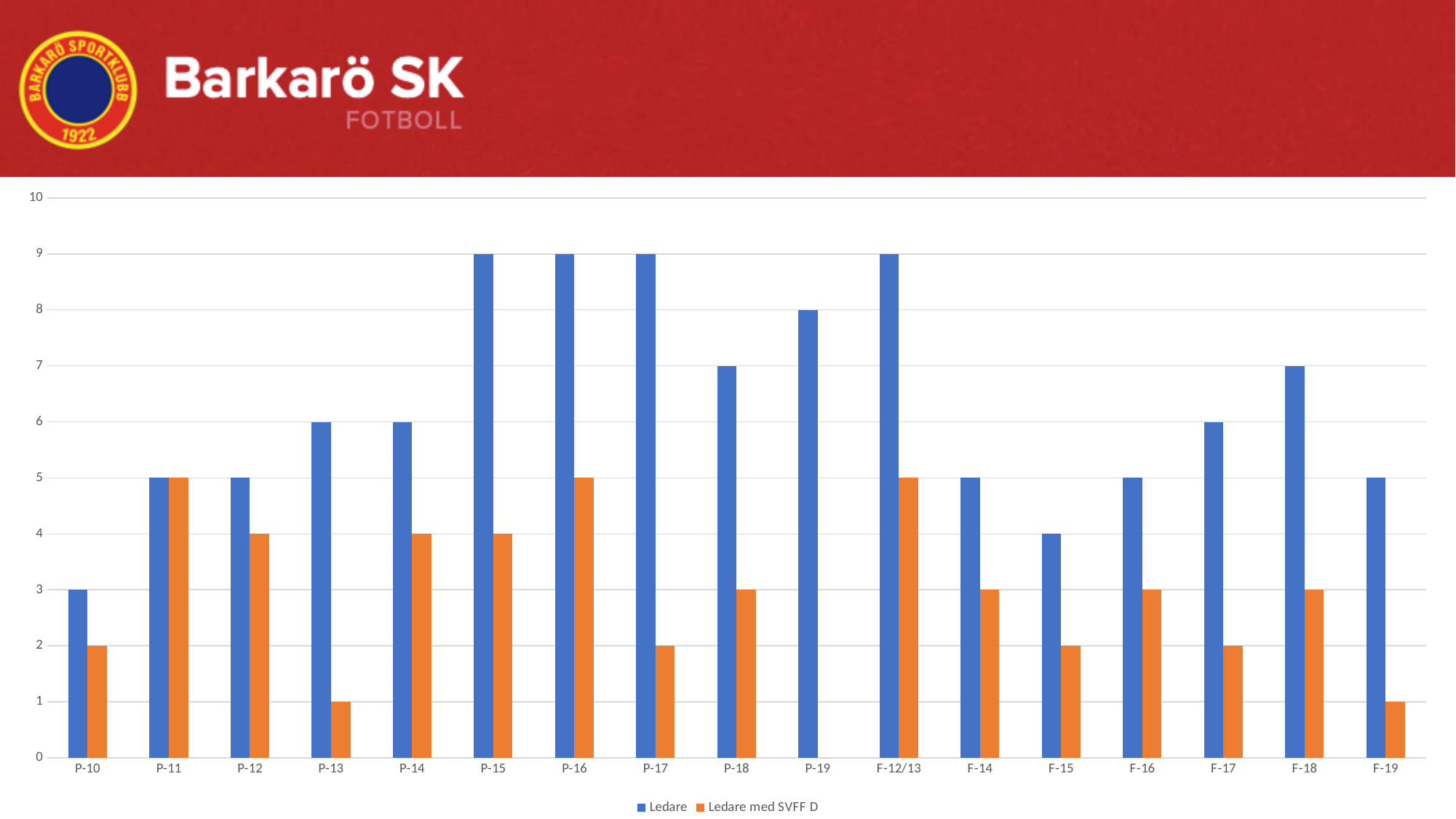
Which category has the lowest value for Ledare? P-10 What colour are the bars for the Ledare med SVFF D series? orange What type of chart is shown on the slide? bar chart Which is larger for P-18: Ledare or Ledare med SVFF D? Ledare What is the value of Ledare med SVFF D for F-12/13? 5 What is the value of Ledare med SVFF D for P-13? 1 How many categories are shown on the x axis? 17 Is the value of Ledare for F-18 greater or less than 5? greater What is the value of Ledare for P-19? 8 What is the difference between Ledare and Ledare med SVFF D for P-17? 7 What is the value of Ledare for F-15? 4 How many series does the legend list? 2